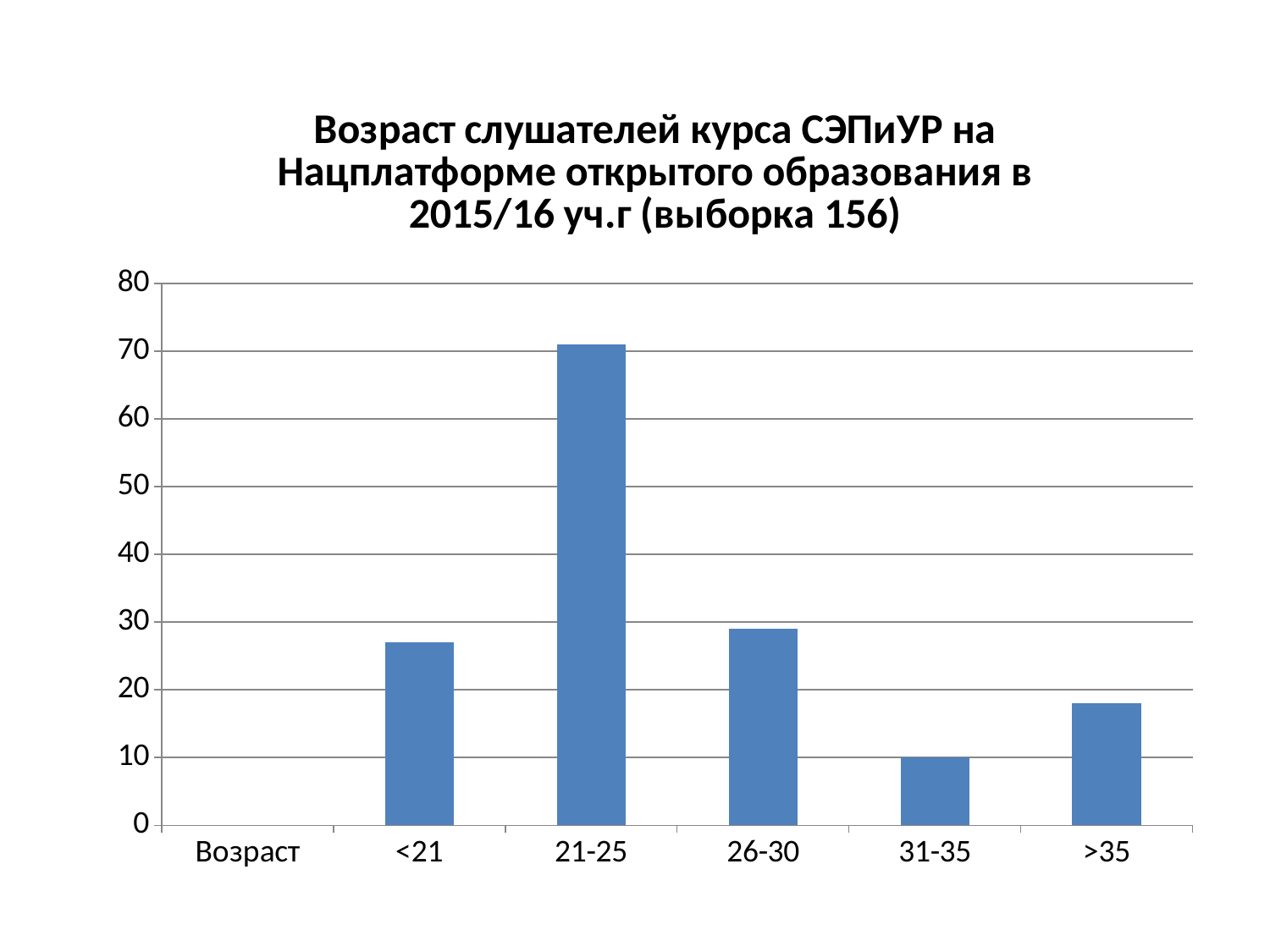
Which is larger, the value for <21 or the value for >35? <21 Is the value for the 26-30 age group greater or less than 20? greater What kind of chart is shown on the slide? bar chart Which is larger, the value for 31-35 or the value for >35? >35 What is the value for the 31-35 age group? 10 Is the value for the 21-25 age group greater or less than 60? greater Is the value for the <21 age group greater or less than 30? less How many bars are plotted in the chart? 5 What sample size is stated in the chart title? 156 Which age group has the highest bar? 21-25 Which age group has the lowest bar? 31-35